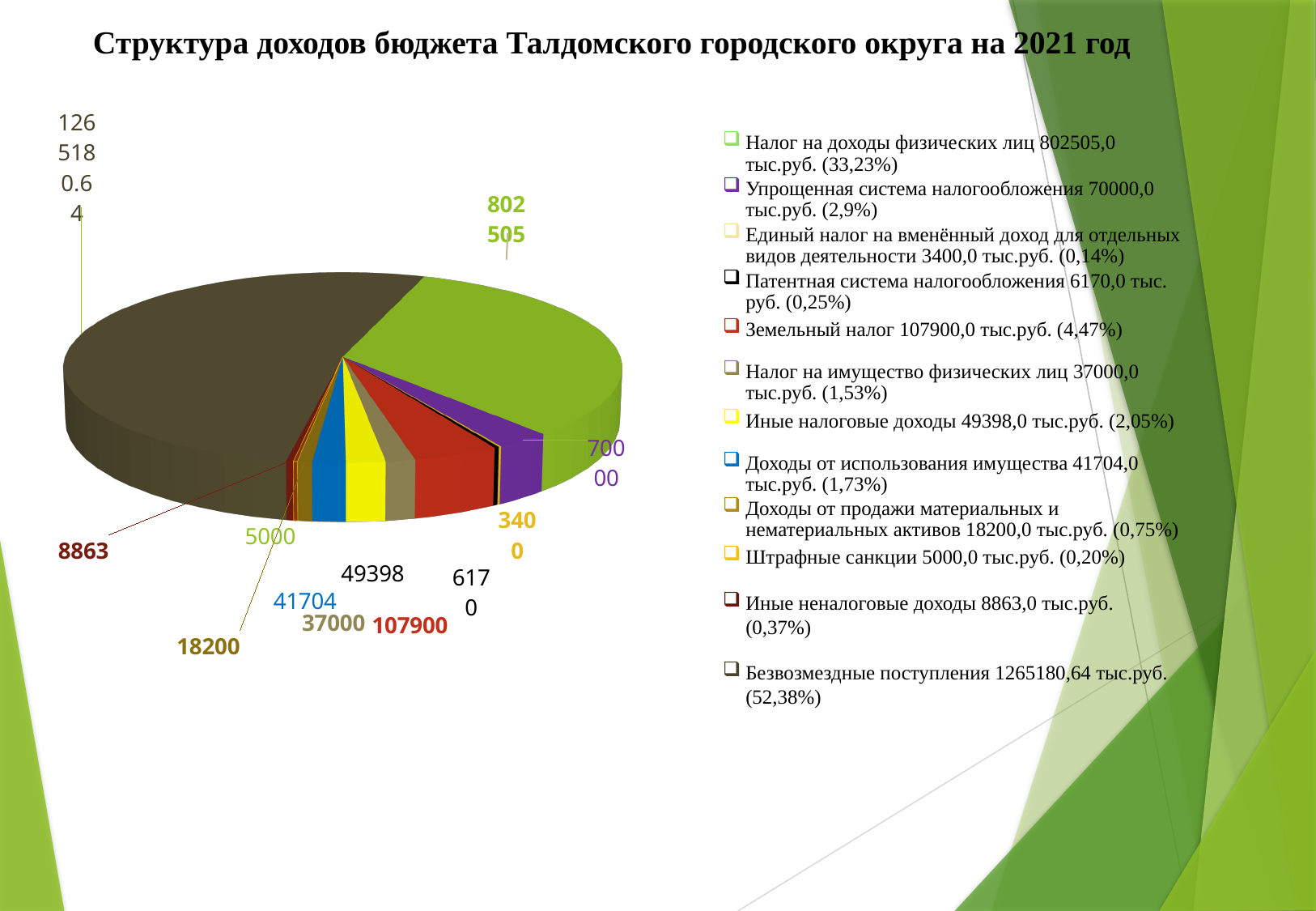
What value is labelled on the pie chart for Земельный налог? 107900 What share of the pie does Безвозмездные поступления represent? 52,38% What kind of chart is shown on the slide? pie chart What value is labelled on the pie chart for Штрафные санкции? 5000 How many slices does the pie chart have? 12 Which is larger: Земельный налог or Упрощенная система налогообложения? Земельный налог What is the difference between the values for Иные налоговые доходы (49398) and Доходы от использования имущества (41704)? 7694 What is the title of the slide containing the pie chart? Структура доходов бюджета Талдомского городского округа на 2021 год Which is larger: Налог на доходы физических лиц or Безвозмездные поступления? Безвозмездные поступления What value is labelled on the pie chart for Доходы от использования имущества? 41704 Which category has the largest slice of the pie chart? Безвозмездные поступления Which category has the smallest slice of the pie chart? Единый налог на вменённый доход для отдельных видов деятельности